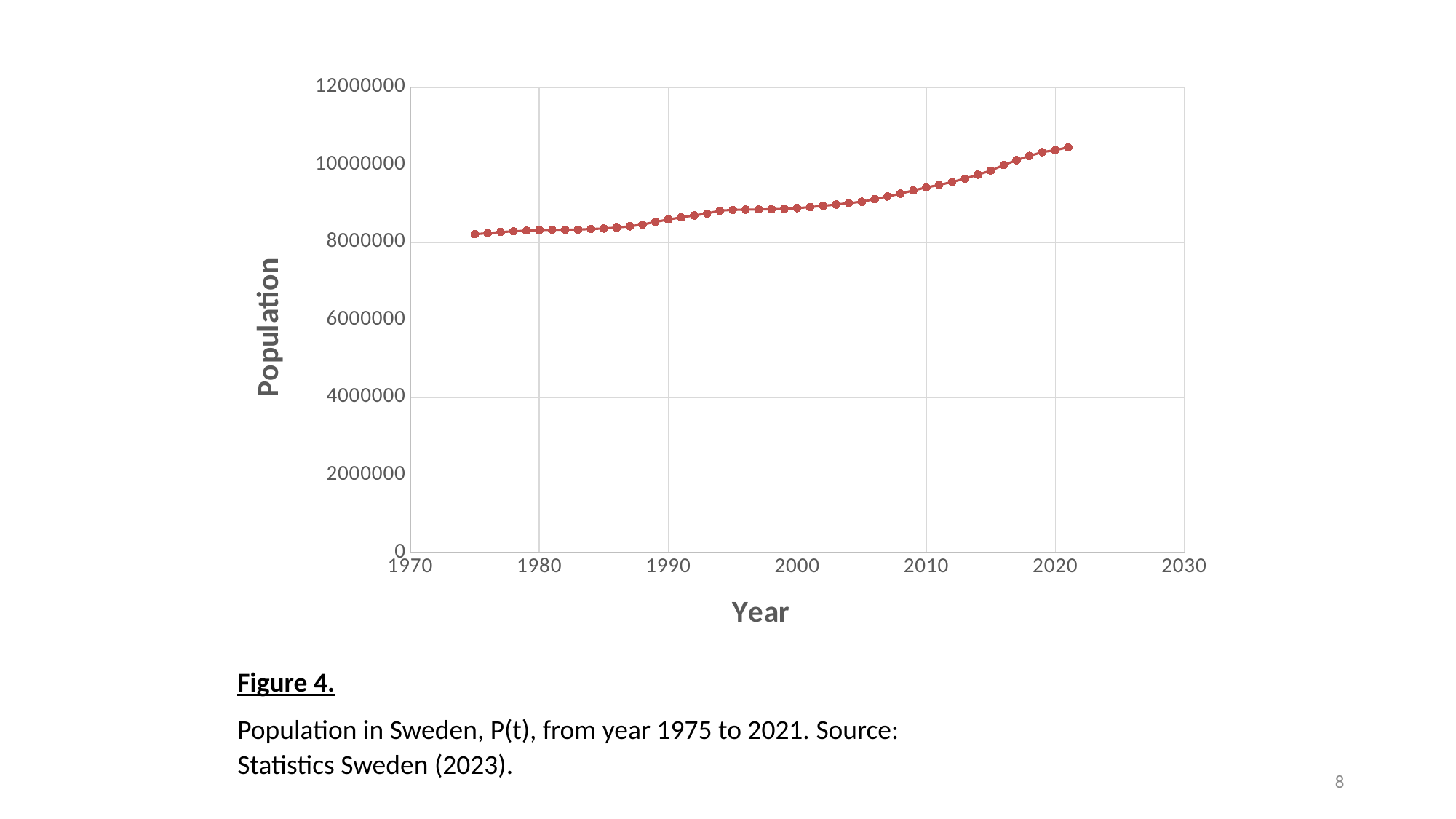
Does the population rise or fall as the year increases along the x axis? rise Is the population value for 1990 greater or less than 10000000? less What kind of chart is shown on the slide? scatter chart Which is larger, the population in 2020 or the population in 1980? 2020 Which year has the highest population value plotted? 2021 Over which range of years is the population plotted, according to the figure caption? 1975 to 2021 Which year has the lowest population value plotted? 1975 Is the population value for 2021 greater or less than 10000000? greater What is the label of the vertical axis? Population Is the population value for 1975 greater or less than 8000000? greater What is the label of the horizontal axis? Year